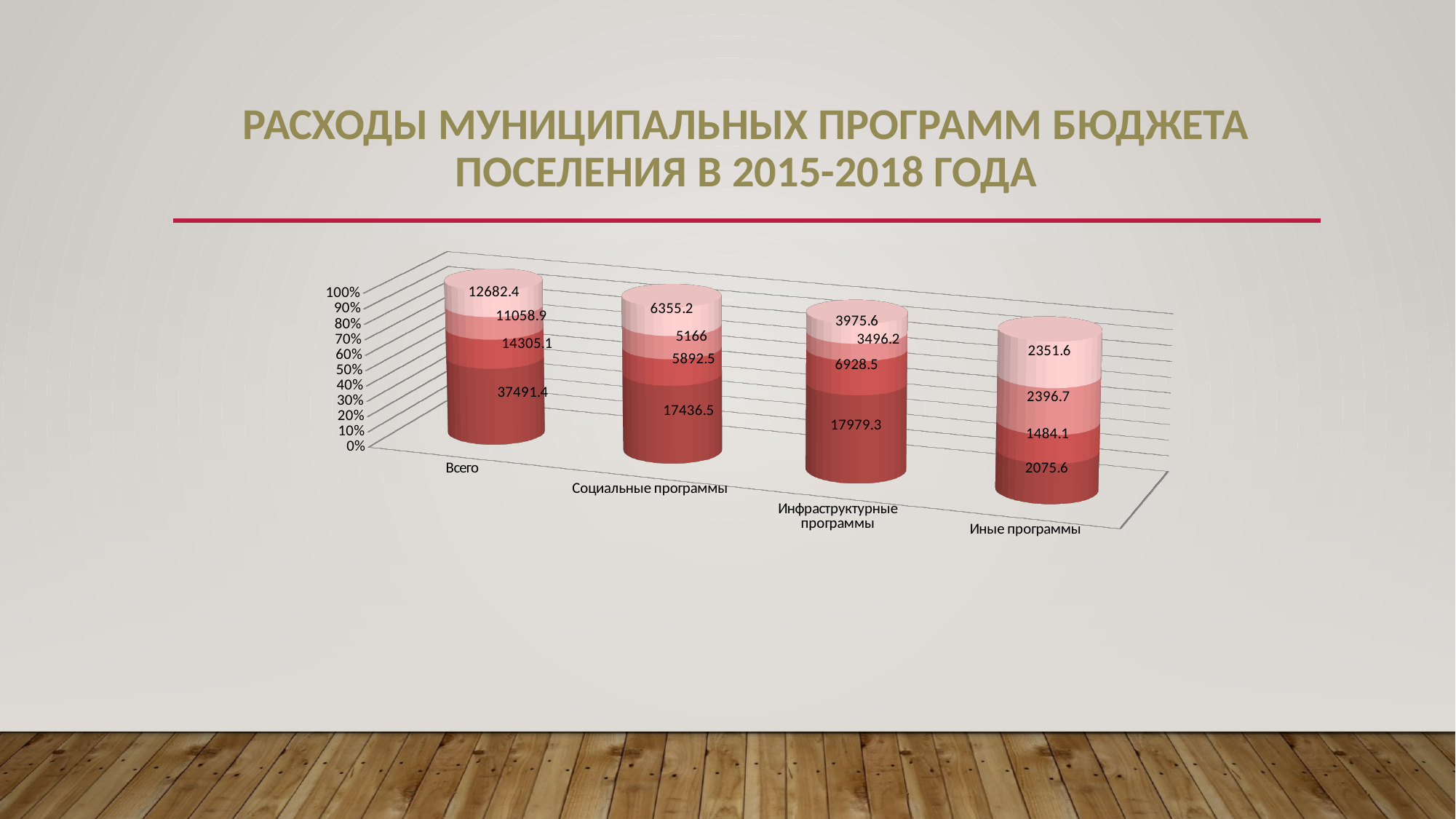
How many categories are shown along the x axis of the chart? 4 What is the value of the top segment of the bar for Иные программы? 2351.6 What is the value of the bottom segment of the bar for Инфраструктурные программы? 17979.3 What is the difference between the bottom segment values of Инфраструктурные программы and Социальные программы? 542.8 Which is larger: the top segment of Всего (12682.4) or the second segment from the top of Всего (11058.9)? 12682.4 What is the value of the bottom segment of the bar for Всего? 37491.4 What kind of chart is shown on the slide? stacked bar chart What is the total of all four segments of the bar for Иные программы? 8308 Which category has the smallest bottom segment value? Иные программы Which category has the largest bottom segment value? Всего What is the title of the chart slide? Расходы муниципальных программ бюджета поселения в 2015-2018 года What is the value of the top segment of the bar for Социальные программы? 6355.2